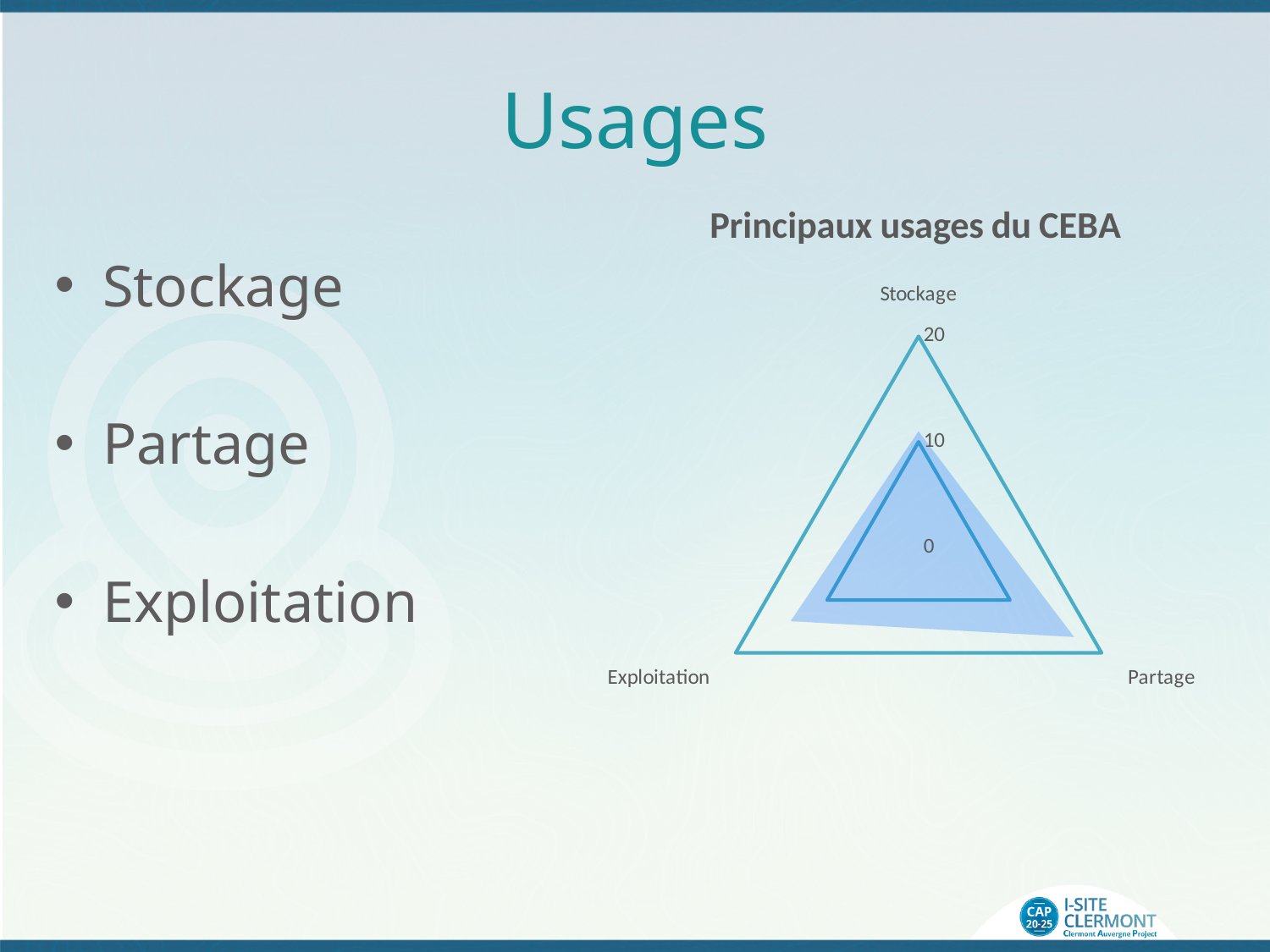
How many categories (axes) does the radar chart have? 3 Is the value for Partage greater or less than 10? greater Which category has the lowest value in the chart? Stockage Is the value for Stockage greater or less than 20? less Which is larger, the value for Partage or the value for Stockage? Partage What is the maximum value shown on the chart's axis scale? 20 Which category has the highest value in the chart? Partage What kind of chart is shown on the slide? radar chart What is the title of the chart? Principaux usages du CEBA Which is larger, the value for Exploitation or the value for Stockage? Exploitation Is the value for Exploitation greater or less than 10? greater